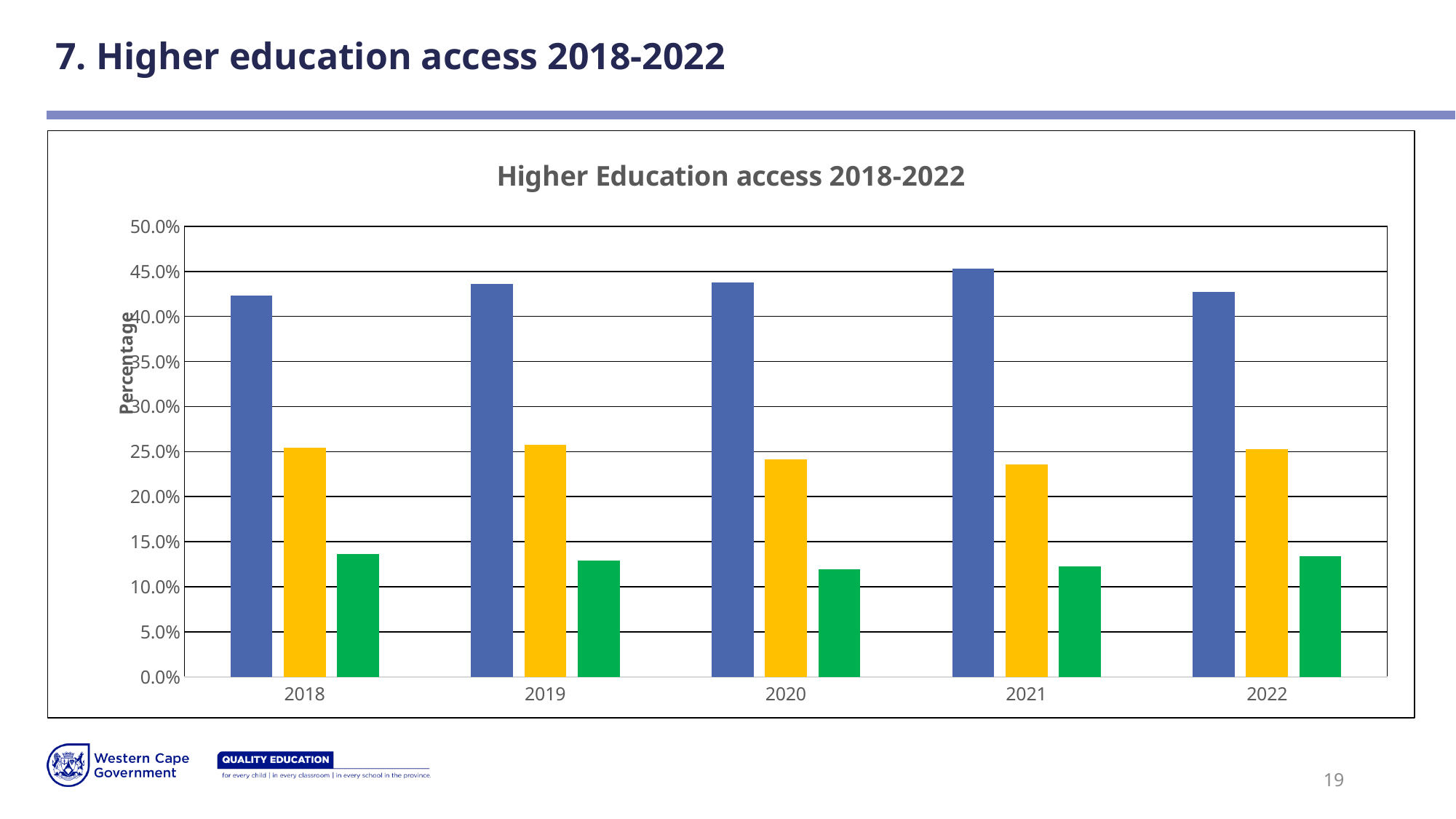
How many years are shown along the x axis of the chart? 5 Is the value of the green bar for 2018 greater or less than 15.0%? less Is the value of the yellow bar for 2021 greater or less than 25.0%? less What kind of chart is shown on the slide? Bar chart Is the value of the yellow bar for 2020 greater or less than 25.0%? less In 2018, which is larger: the yellow bar or the green bar? The yellow bar What is the label on the vertical axis of the chart? Percentage In which year is the blue bar the highest? 2021 What is the title of the chart? Higher Education access 2018-2022 In 2020, which is larger: the blue bar or the yellow bar? The blue bar